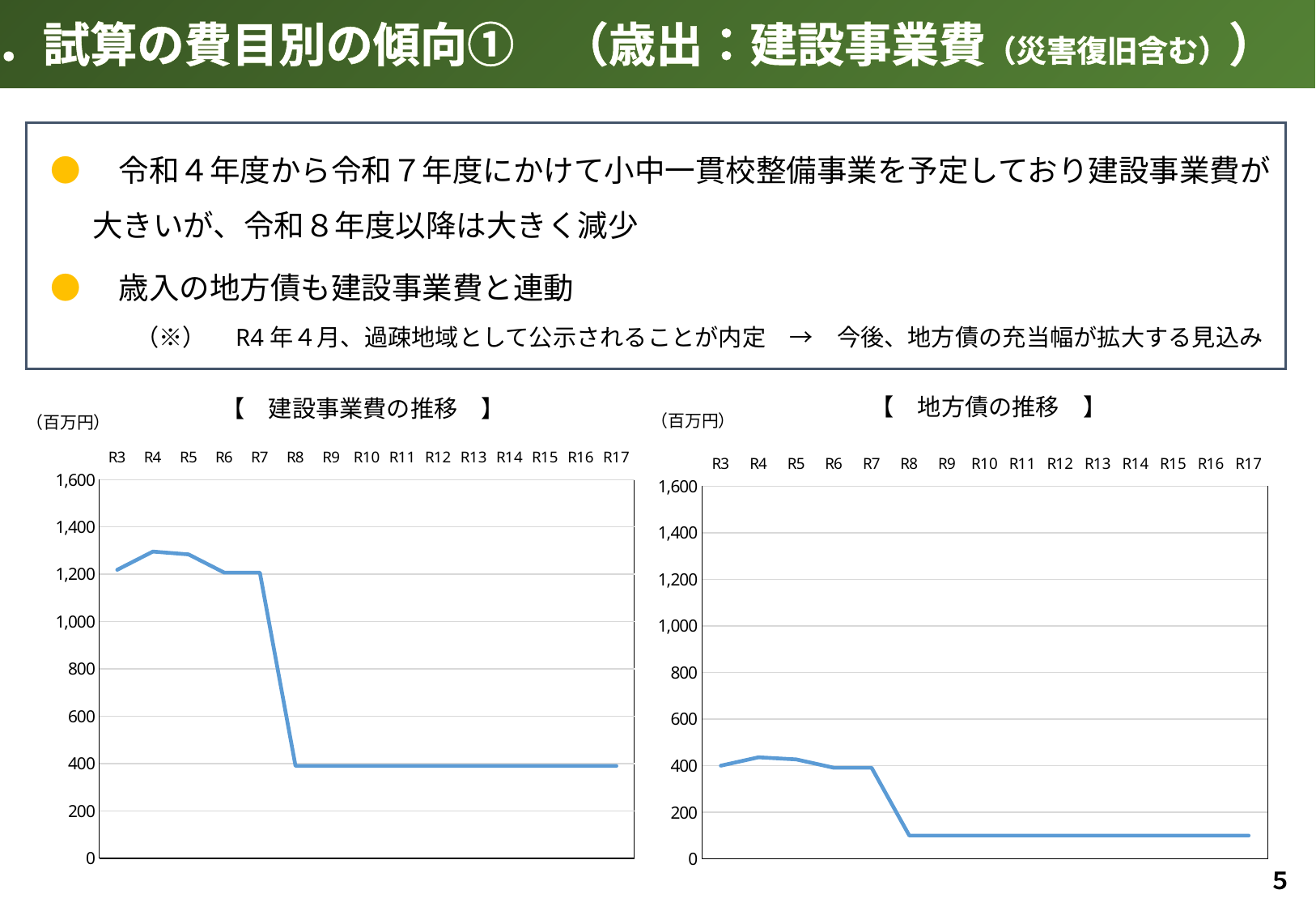
What kind of chart is the 建設事業費の推移 chart on the left? line chart In the 地方債の推移 chart, which is larger, the value for R5 or the value for R9? R5 In the 地方債の推移 chart, is the value for R4 greater or less than 400? greater In the 建設事業費の推移 chart, is the value for R10 greater or less than 600? less What kind of chart is the 地方債の推移 chart on the right? line chart In the 建設事業費の推移 chart, which is larger, the value for R7 or the value for R8? R7 In the 建設事業費の推移 chart, do the values overall rise or fall from R3 to R17? fall What unit is shown above the y axis of the 地方債の推移 chart? 百万円 In the 建設事業費の推移 chart, is the value for R4 greater or less than 1,200? greater In the 地方債の推移 chart, how many years are plotted along the x axis? 15 In the 建設事業費の推移 chart, how many years are plotted along the x axis? 15